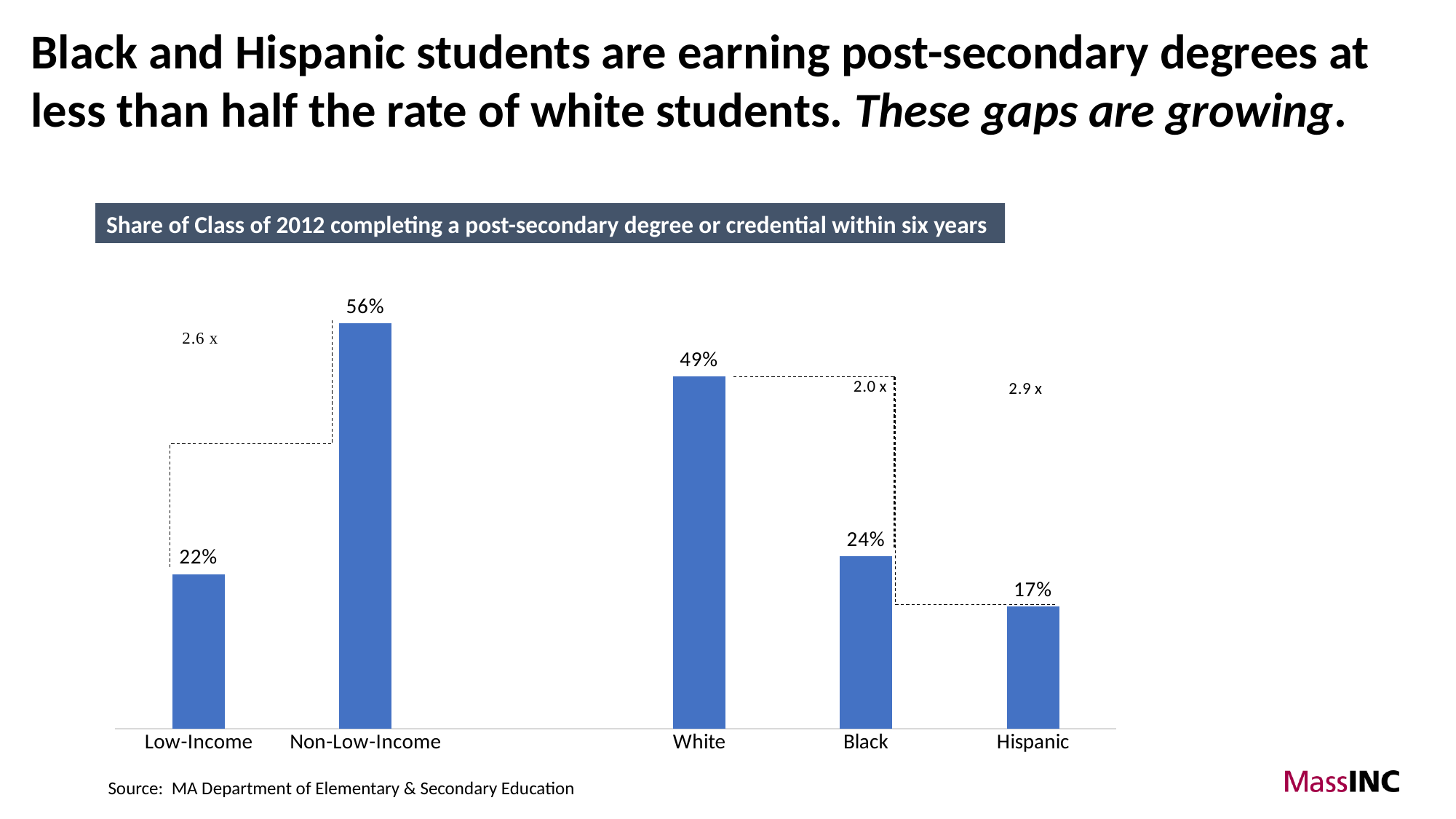
Which category has the highest value? Non-Low-Income What kind of chart is shown on the slide? Bar chart Which category has the lowest value? Hispanic What is the value for Low-Income? 22% Which is larger, the value for Black or the value for Hispanic? Black What is the difference between the values for White and Black? 25% What is the value for Hispanic? 17% What is the value for White? 49% What is the value for Black? 24% What is the difference between the values for Non-Low-Income and Low-Income? 34% What is the value for Non-Low-Income? 56% How many categories are shown on the chart? 5